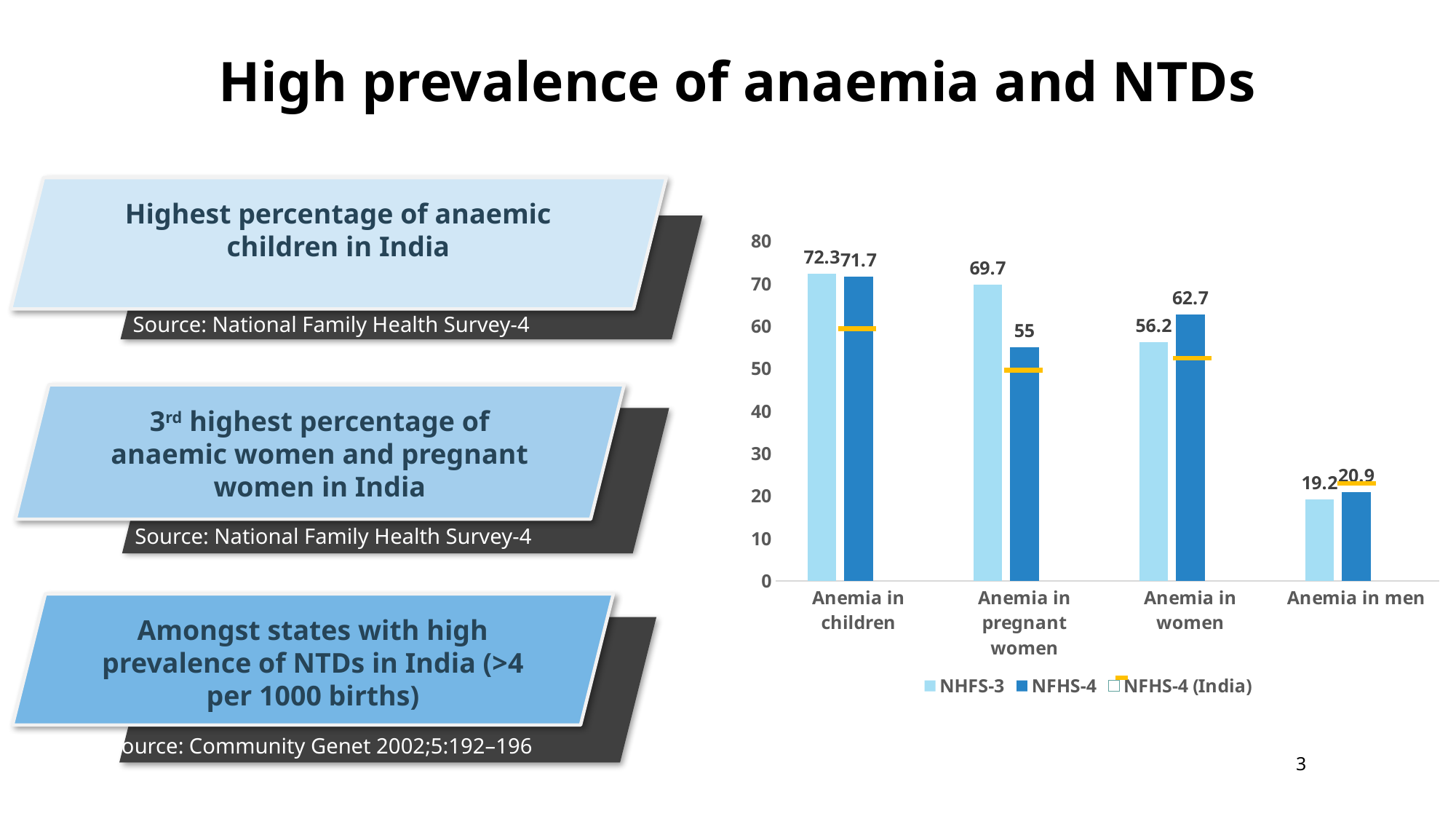
For Anemia in women, which is larger: the NHFS-3 value or the NFHS-4 value? NFHS-4 How many categories are shown on the x axis of the chart? 4 What is the NHFS-3 value for Anemia in children? 72.3 What kind of chart is shown on the slide? Bar chart Is the NFHS-4 (India) marker for Anemia in pregnant women greater or less than 60? less Which category has the highest NFHS-4 value? Anemia in children What is the NFHS-4 value for Anemia in women? 62.7 What is the NFHS-4 value for Anemia in pregnant women? 55 Which category has the lowest NHFS-3 value? Anemia in men How many series does the chart legend list? 3 What is the difference between the NHFS-3 and NFHS-4 values for Anemia in pregnant women? 14.7 What is the NHFS-3 value for Anemia in men? 19.2